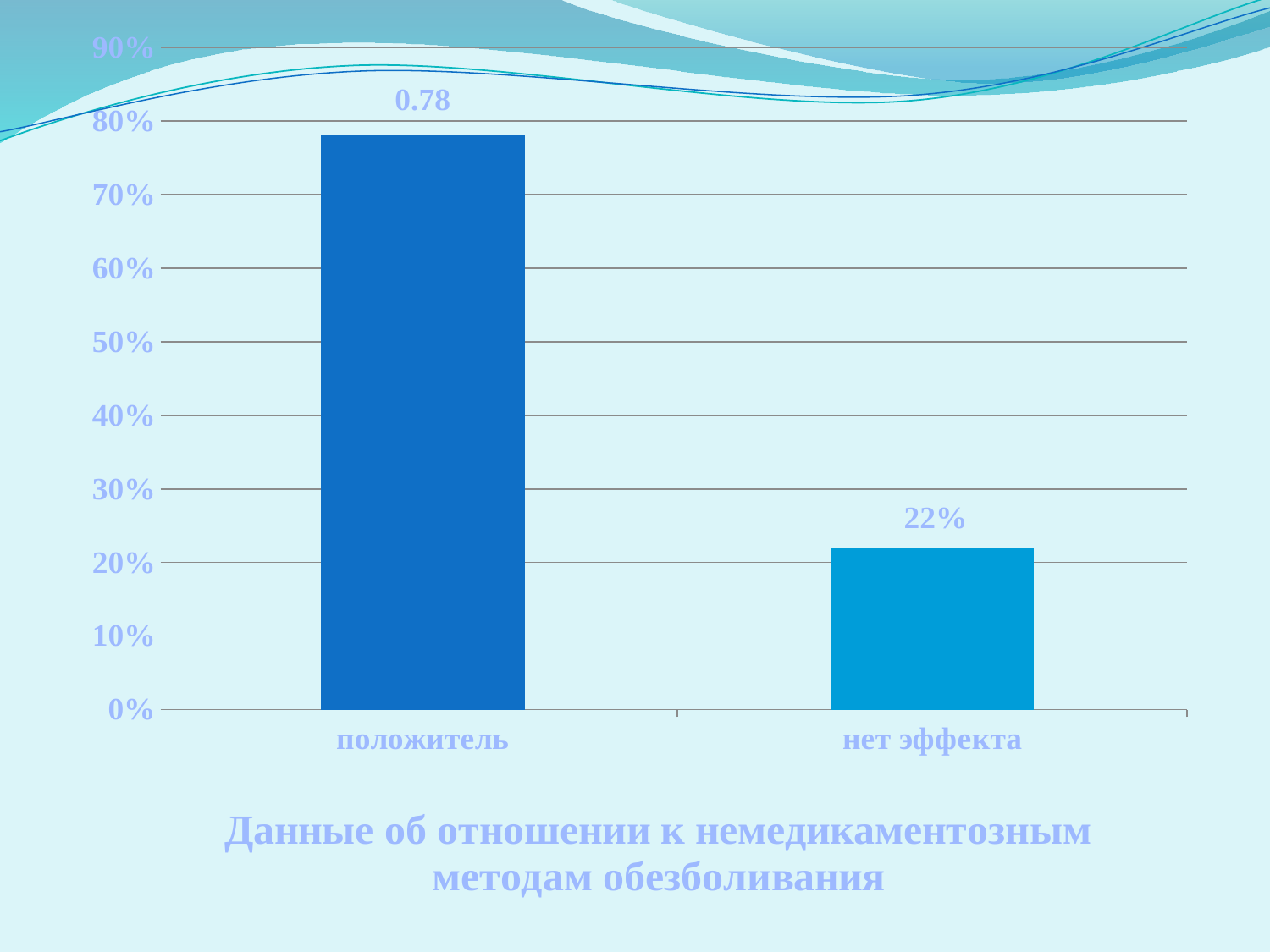
How many categories are shown on the x axis? 2 What value is shown as the data label for the "положитель" bar? 0.78 Which category has the highest bar? положитель Is the value for "нет эффекта" greater or less than 30%? less Which bar is taller, "положитель" or "нет эффекта"? положитель Is the value for "положитель" greater or less than 80%? less What is the highest value shown on the y axis? 90% What kind of chart is shown on the slide? bar chart What is the title text shown below the chart? Данные об отношении к немедикаментозным методам обезболивания Which category has the lowest bar? нет эффекта What value is shown as the data label for the "нет эффекта" bar? 22% Is the value for "положитель" greater or less than 70%? greater